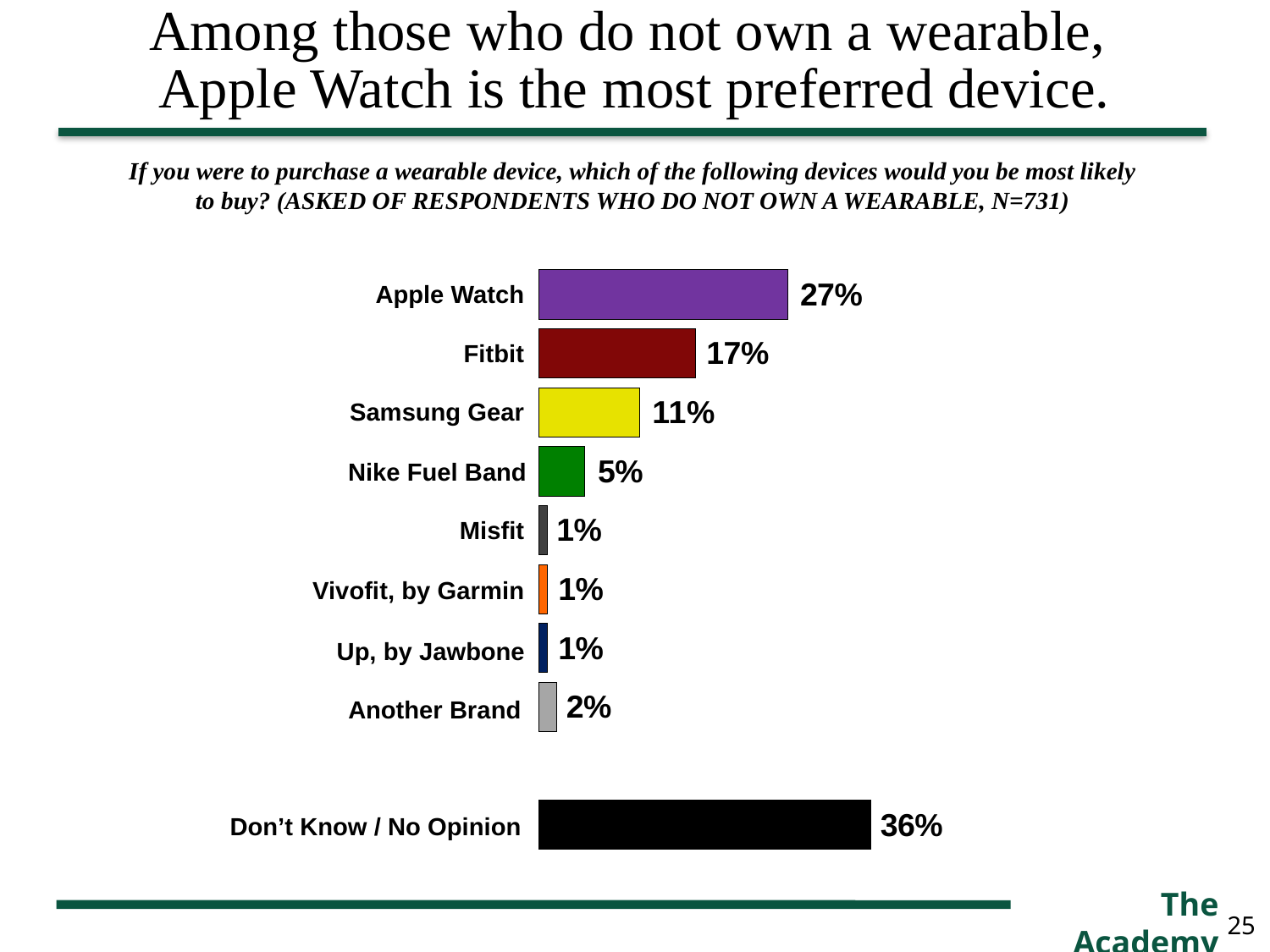
What percentage of respondents would be most likely to buy an Apple Watch? 27% How many categories are shown in the chart, including Don't Know / No Opinion? 9 What kind of chart is shown on the slide? Bar chart Which named device brand has the highest percentage? Apple Watch What percentage is shown for Don't Know / No Opinion? 36% What is the value shown for Fitbit? 17% What is the value shown for Samsung Gear? 11% What is the difference between the Don't Know / No Opinion value and the Apple Watch value? 9% Which is larger, the value for Samsung Gear or the value for Nike Fuel Band? Samsung Gear What is the value shown for Another Brand? 2% What colour is the bar for Apple Watch? Purple What is the difference in percentage points between Apple Watch and Fitbit? 10%